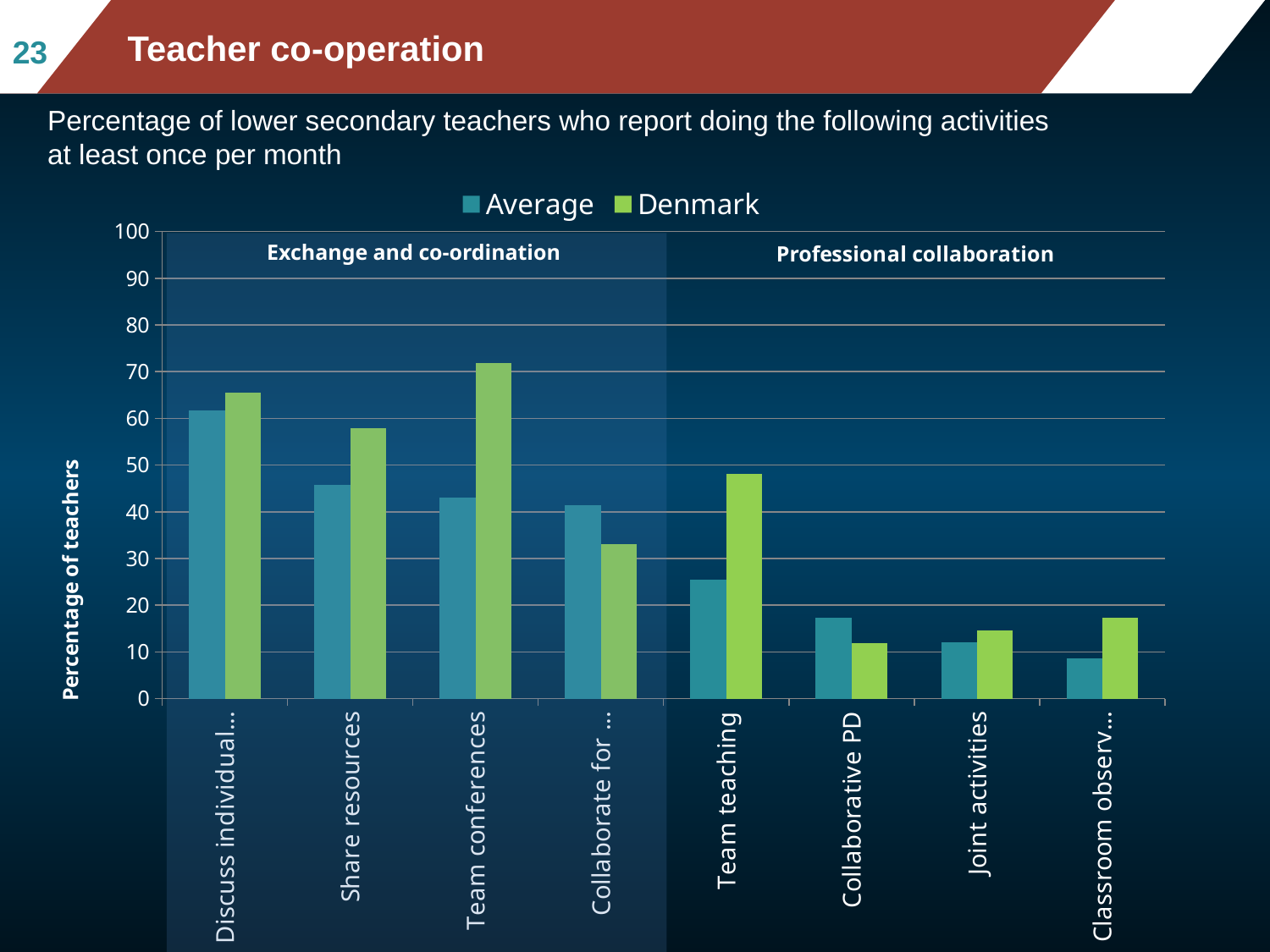
What kind of chart is shown on the slide? bar chart Is the Average value for Team teaching greater or less than 30? less For Collaborate for ..., which is larger: the Average value or the Denmark value? Average For Collaborative PD, which is larger: the Average value or the Denmark value? Average How many series does the legend list? 2 Which category has the lowest Average value? Classroom observ... Which category has the highest Denmark value? Team conferences How many activity categories are plotted along the x axis? 8 Is the Denmark value for Team conferences greater or less than 60? greater What is the label of the y axis? Percentage of teachers Which category has the highest Average value? Discuss individual... For Team conferences, which is larger: the Average value or the Denmark value? Denmark